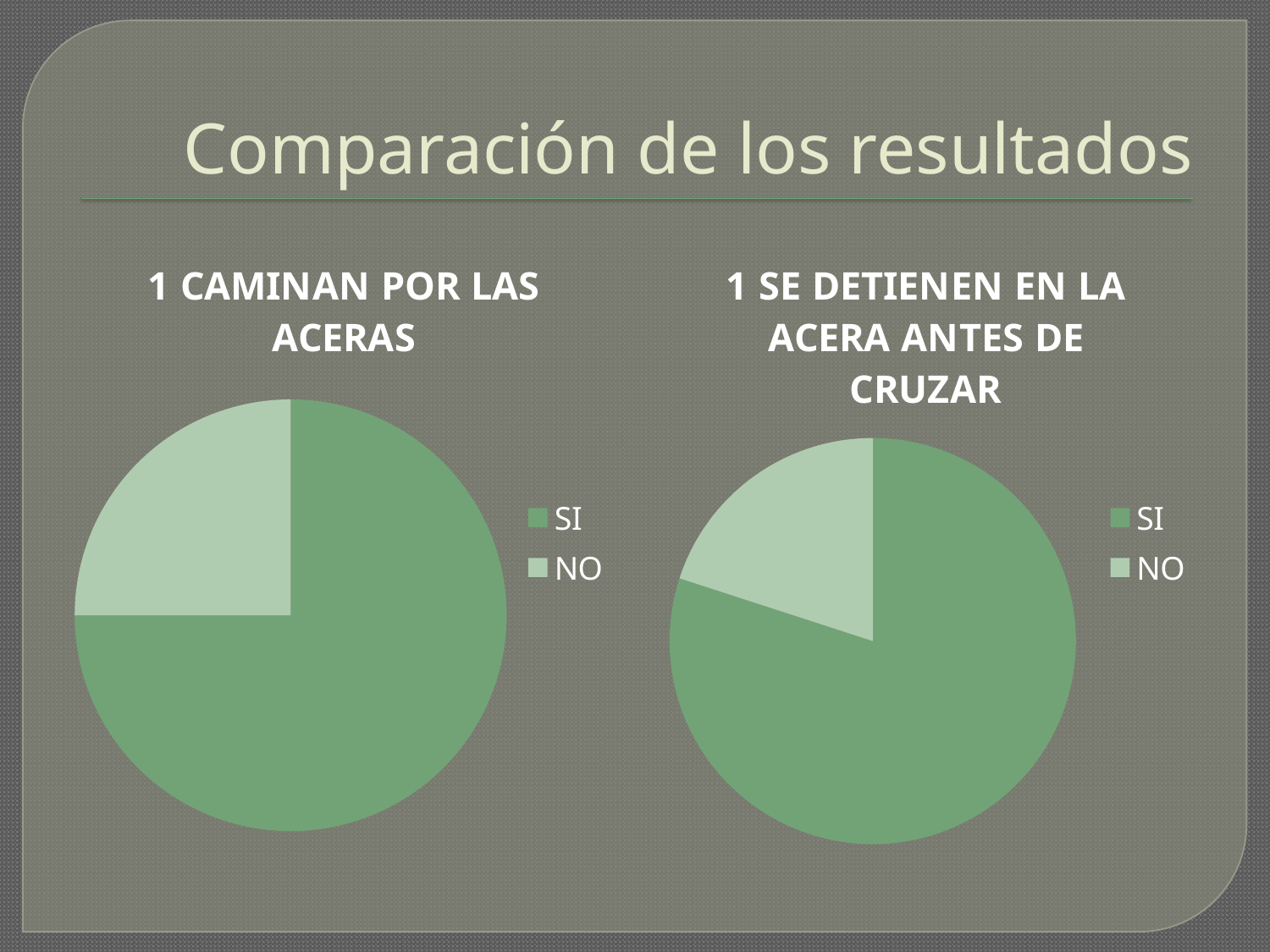
In the chart titled "1 SE DETIENEN EN LA ACERA ANTES DE CRUZAR", which slice is larger, SI or NO? SI In the chart titled "1 SE DETIENEN EN LA ACERA ANTES DE CRUZAR", which category has the smallest slice? NO How many entries does the legend of the chart titled "1 SE DETIENEN EN LA ACERA ANTES DE CRUZAR" list? 2 In the chart titled "1 SE DETIENEN EN LA ACERA ANTES DE CRUZAR", which category has the largest slice? SI What are the legend entries of the pie chart on the right of the slide? SI, NO What is the title of the pie chart on the left of the slide? 1 CAMINAN POR LAS ACERAS In the chart titled "1 CAMINAN POR LAS ACERAS", which category has the smallest slice? NO What kind of chart is the chart titled "1 SE DETIENEN EN LA ACERA ANTES DE CRUZAR"? pie chart In the chart titled "1 CAMINAN POR LAS ACERAS", which category has the largest slice? SI What kind of chart is the chart titled "1 CAMINAN POR LAS ACERAS"? pie chart How many slices does the chart titled "1 CAMINAN POR LAS ACERAS" have? 2 In the chart titled "1 CAMINAN POR LAS ACERAS", which slice is larger, SI or NO? SI